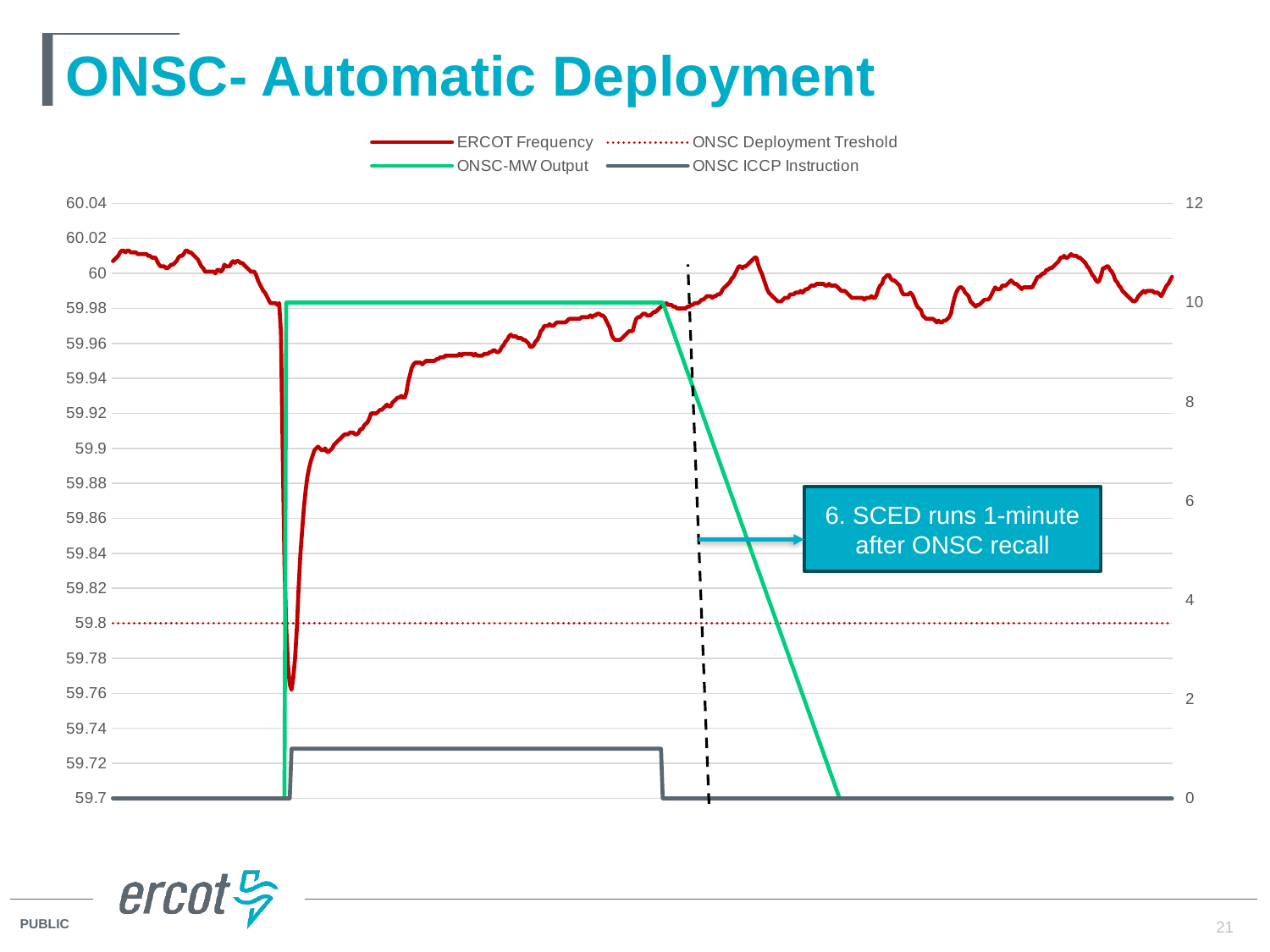
Which series is drawn as a dotted line in the legend? ONSC Deployment Treshold At what frequency value on the left axis is the ONSC Deployment Treshold line drawn? 59.8 Is the ONSC Deployment Treshold line greater or less than 59.9 on the left axis? less What kind of chart is shown on the slide? line chart How many series does the legend list? 4 Is the lowest point of the ERCOT Frequency line greater or less than 59.78? less At what value on the right axis does the ONSC-MW Output plateau sit? 10 What is the highest value shown on the right-hand axis? 12 After the dashed vertical line, does the ONSC-MW Output rise or fall? fall Is the plateau of the ONSC ICCP Instruction line greater or less than 2 on the right axis? less What is the title of the chart on the slide? ONSC- Automatic Deployment